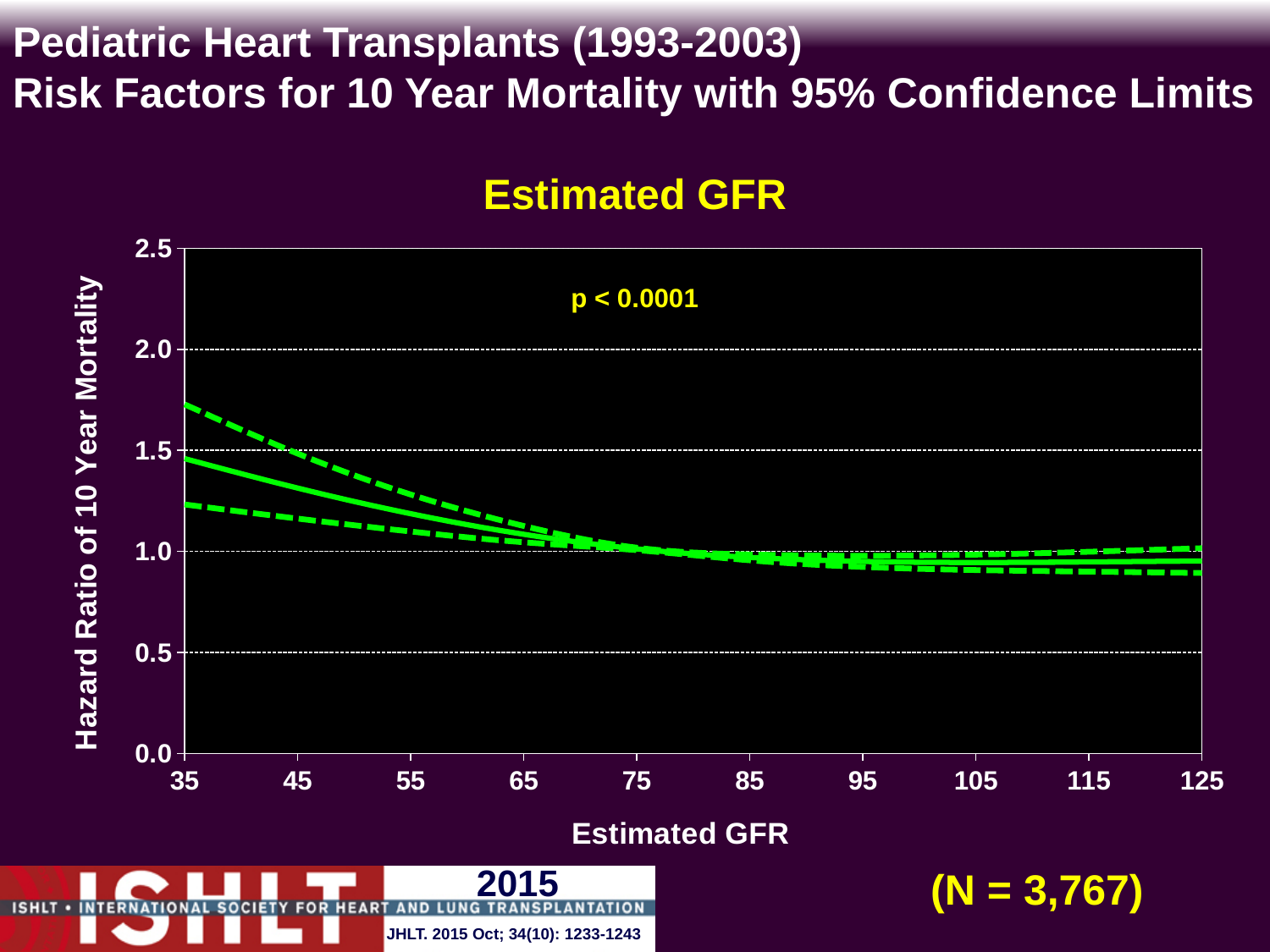
Is the hazard ratio shown by the solid line at an estimated GFR of 125 greater or less than 1.5? less What kind of chart is shown on the slide? line chart What p-value is printed on the chart? p < 0.0001 What is the title of the chart? Estimated GFR Is the hazard ratio shown by the solid line at an estimated GFR of 35 greater or less than 1.0? greater How many lines are plotted on the chart? 3 Does the hazard ratio of 10 year mortality rise or fall as estimated GFR increases from 35 to 75? fall Is the lower confidence limit (lower dashed line) at an estimated GFR of 35 greater or less than 1.5? less Is the hazard ratio at an estimated GFR of 35 higher or lower than at an estimated GFR of 85? higher What is the highest value shown on the y axis of the chart? 2.5